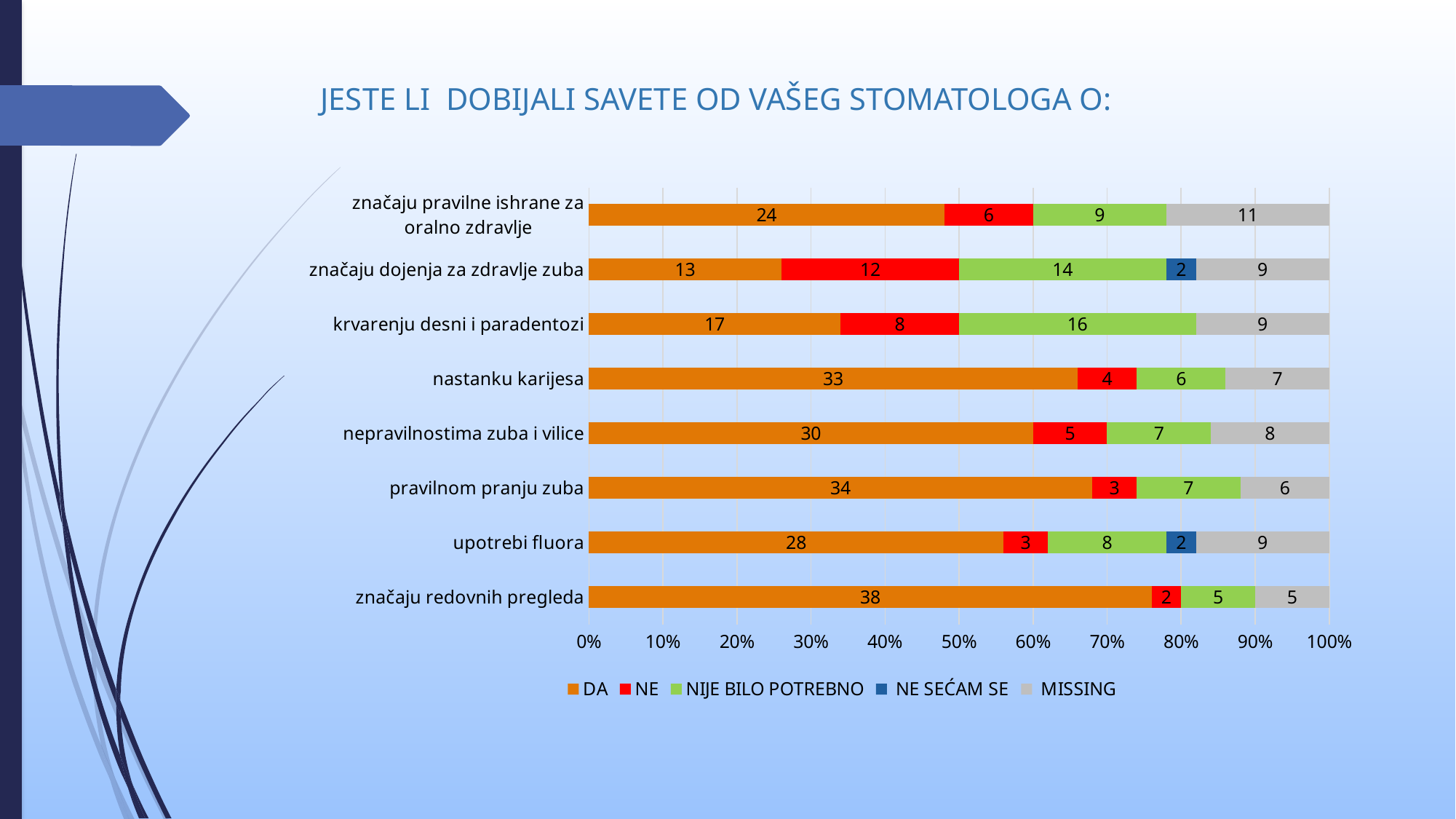
What is the DA value for "nastanku karijesa"? 33 Which category has the lowest DA value? značaju dojenja za zdravlje zuba How many categories are shown on the chart? 8 What is the total of all segments in the bar for "upotrebi fluora"? 50 What is the MISSING value for "značaju pravilne ishrane za oralno zdravlje"? 11 Which is larger, the NE value for "krvarenju desni i paradentozi" or the NE value for "nastanku karijesa"? krvarenju desni i paradentozi Which category has the highest DA value? značaju redovnih pregleda What is the difference between the DA values for "pravilnom pranju zuba" and "upotrebi fluora"? 6 What is the NE value for "značaju dojenja za zdravlje zuba"? 12 What kind of chart is shown on the slide? stacked bar chart How many series does the legend list? 5 What is the NIJE BILO POTREBNO value for "krvarenju desni i paradentozi"? 16